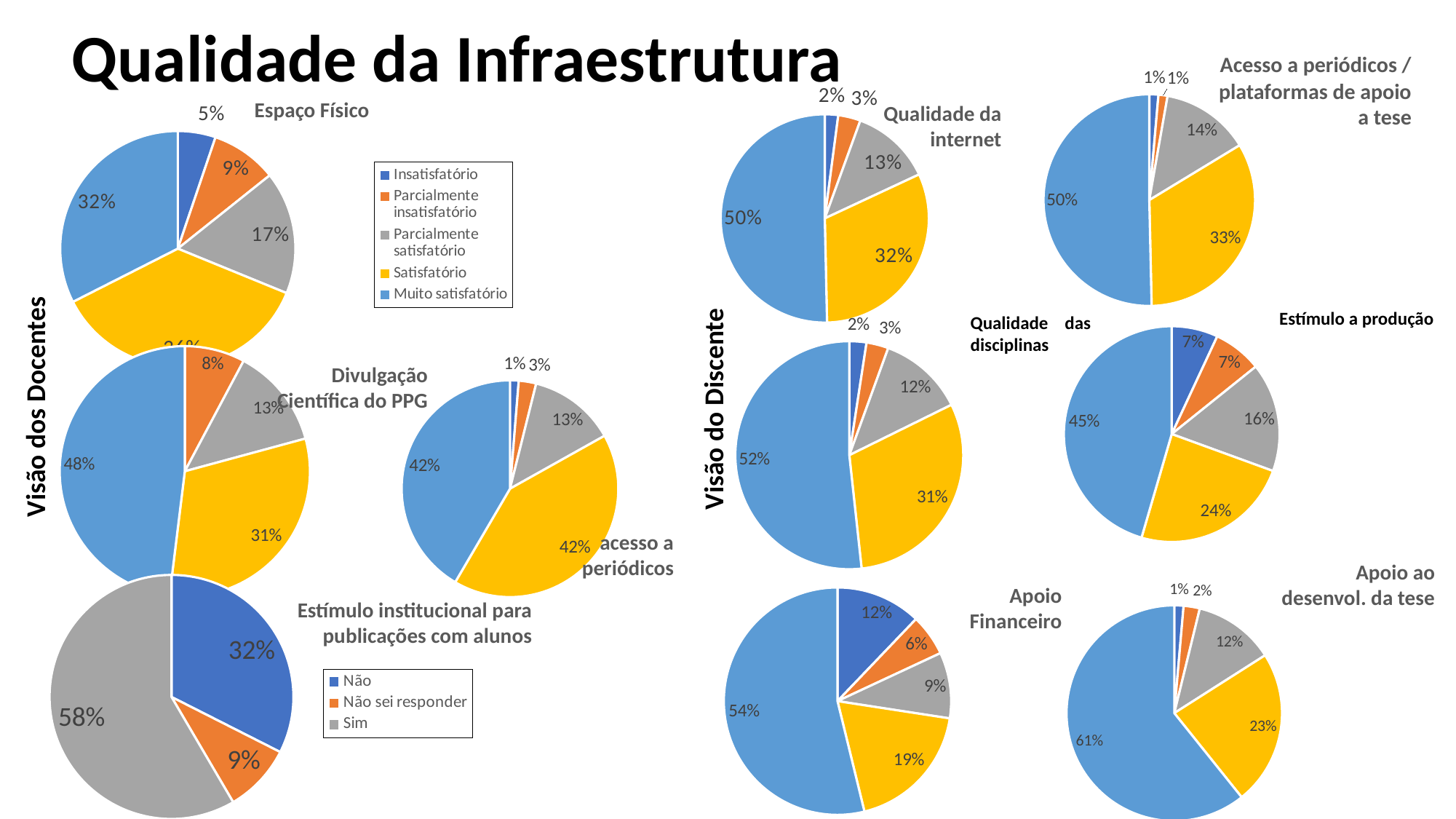
In the 'Estímulo a produção' pie chart, which category has the largest share? Muito satisfatório How many entries does the legend next to the 'Espaço Físico' chart list? 5 How many slices does the 'Estímulo institucional para publicações com alunos' pie chart have? 3 In the 'Estímulo institucional para publicações com alunos' pie chart, what percentage answered 'Sim'? 58% What type of chart is used for 'Qualidade das disciplinas'? Pie chart In the 'Qualidade da internet' pie chart, what is the share of the 'Satisfatório' slice? 32% In the 'Apoio Financeiro' pie chart, what share is labelled for the 'Muito satisfatório' slice? 54% In the 'Apoio Financeiro' pie chart, what is the difference between the 'Muito satisfatório' share (54%) and the 'Satisfatório' share (19%)? 35% In the 'Apoio ao desenvol. da tese' pie chart, which category has the smallest share? Insatisfatório What is the title of the slide? Qualidade da Infraestrutura In the 'Acesso a periódicos / plataformas de apoio a tese' pie chart, what is the share of the 'Satisfatório' slice? 33% In the 'Divulgação Científica do PPG' pie chart, which is larger: the 'Muito satisfatório' slice or the 'Satisfatório' slice? Muito satisfatório